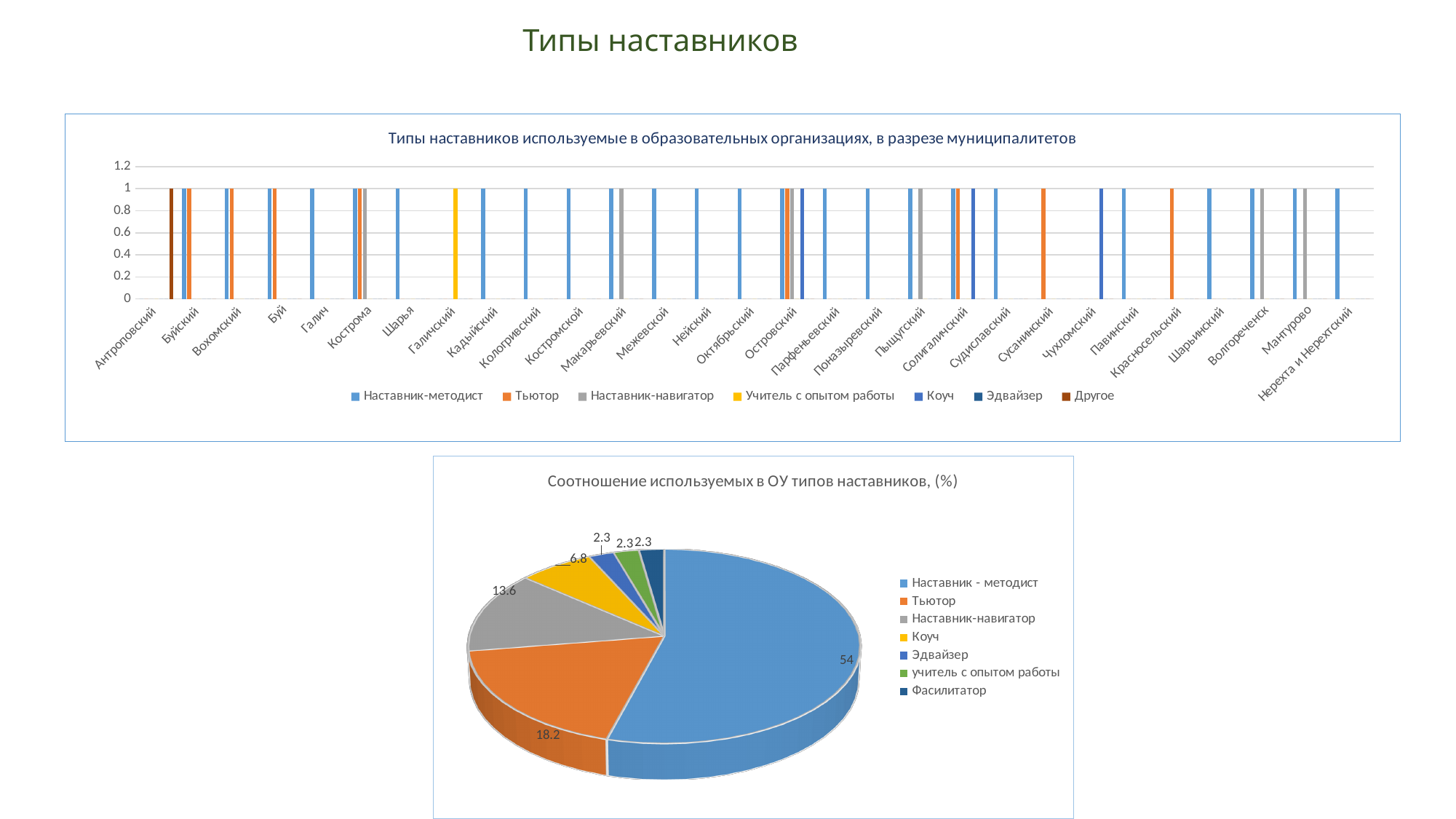
What kind of chart is the upper chart 'Типы наставников используемые в образовательных организациях, в разрезе муниципалитетов'? bar chart What kind of chart is the lower chart 'Соотношение используемых в ОУ типов наставников, (%)'? pie chart In the upper bar chart 'Типы наставников используемые в образовательных организациях, в разрезе муниципалитетов', what is the value of the Наставник-методист bar for Галич? 1 In the pie chart 'Соотношение используемых в ОУ типов наставников, (%)', what is the difference between the values for Тьютор and Наставник-навигатор? 4.6 In the pie chart 'Соотношение используемых в ОУ типов наставников, (%)', which category has the largest slice? Наставник - методист In the pie chart 'Соотношение используемых в ОУ типов наставников, (%)', what is the value for Наставник-навигатор? 13.6 In the pie chart 'Соотношение используемых в ОУ типов наставников, (%)', what is the value for Коуч? 6.8 How many series does the legend of the upper bar chart 'Типы наставников используемые в образовательных организациях, в разрезе муниципалитетов' list? 7 How many municipalities are shown on the x axis of the upper bar chart 'Типы наставников используемые в образовательных организациях, в разрезе муниципалитетов'? 29 In the pie chart 'Соотношение используемых в ОУ типов наставников, (%)', which is larger: Наставник - методист or Коуч? Наставник - методист How many categories does the legend of the pie chart 'Соотношение используемых в ОУ типов наставников, (%)' list? 7 In the pie chart 'Соотношение используемых в ОУ типов наставников, (%)', what is the value for Тьютор? 18.2